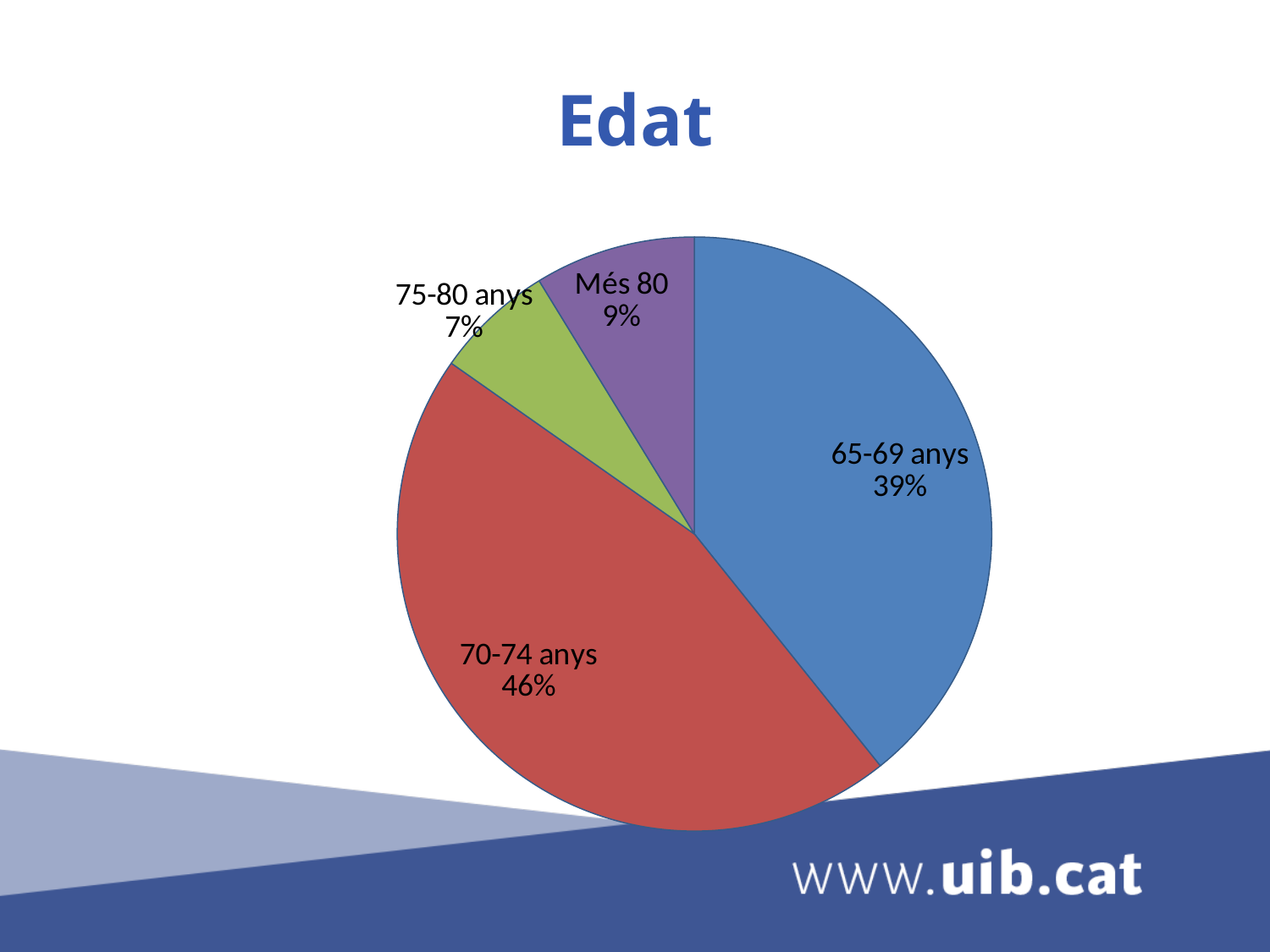
Which age group has the smallest slice of the pie? 75-80 anys What kind of chart is shown on the slide? Pie chart Which slice is larger, Més 80 or 75-80 anys? Més 80 What share of the pie does the 70-74 anys slice represent? 46% How many slices does the pie chart have? 4 What is the value shown for the 75-80 anys slice? 7% What is the value shown for the Més 80 slice? 9% What is the title of the chart? Edat What is the difference in percentage points between the 70-74 anys and 65-69 anys slices? 7 Which age group has the largest slice of the pie? 70-74 anys What colour is the 70-74 anys slice? Red What share of the pie does the 65-69 anys slice represent? 39%